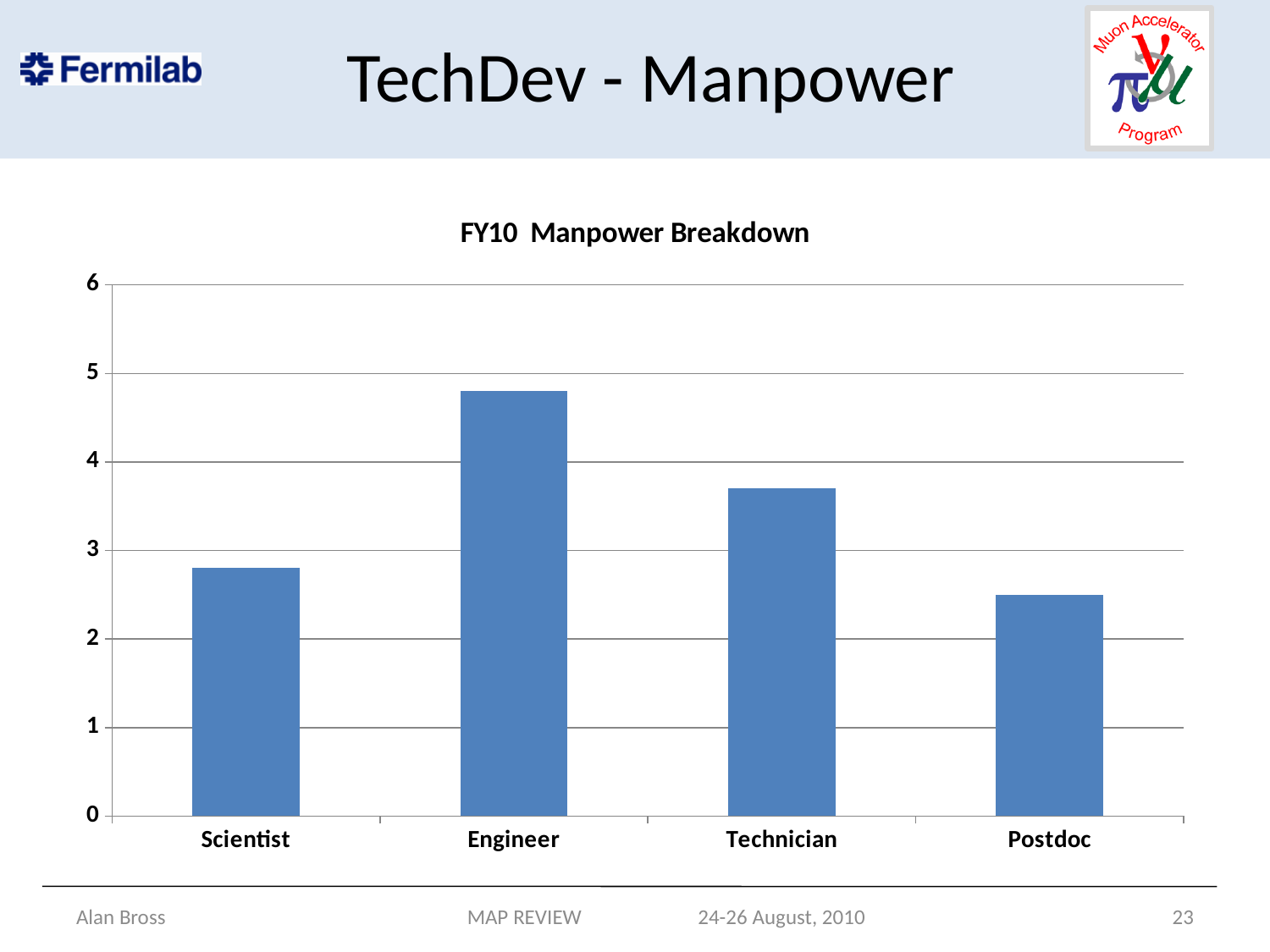
Which is larger, the value for Engineer or the value for Technician? Engineer How many categories are shown on the x axis of the chart? 4 Is the value for Scientist greater or less than 3? less What type of chart is shown on the slide? bar chart Which is larger, the value for Technician or the value for Scientist? Technician Which category has the highest value in the FY10 Manpower Breakdown chart? Engineer Is the value for Engineer greater or less than 4? greater What is the title of the chart? FY10 Manpower Breakdown Which category has the lowest value in the FY10 Manpower Breakdown chart? Postdoc Is the value for Postdoc greater or less than 2? greater What is the highest value shown on the y axis of the chart? 6